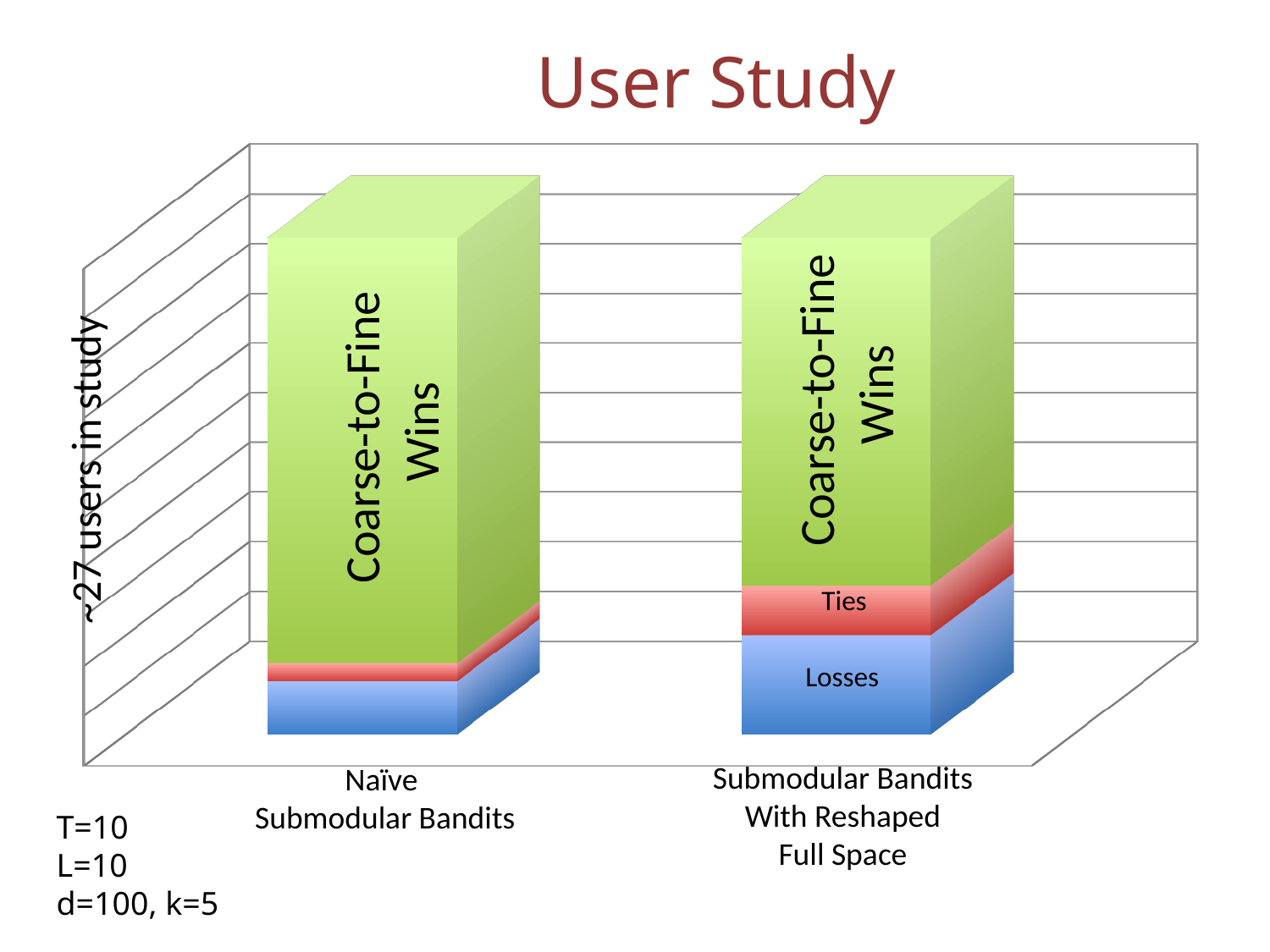
Which segment is the smallest in the Naïve Submodular Bandits bar? Ties What is the title of the chart? User Study Which segment is the smallest in the Submodular Bandits With Reshaped Full Space bar? Ties How many categories (bars) are shown on the x axis? 2 How many stacked segments does each bar contain? 3 Which segment is the largest in the Naïve Submodular Bandits bar? Coarse-to-Fine Wins Which bar has the larger Losses segment, Naïve Submodular Bandits or Submodular Bandits With Reshaped Full Space? Submodular Bandits With Reshaped Full Space What is the label on the vertical axis? ~27 users in study Which bar has the larger Coarse-to-Fine Wins segment, Naïve Submodular Bandits or Submodular Bandits With Reshaped Full Space? Naïve Submodular Bandits What kind of chart is shown on the slide? stacked bar chart Which segment is the largest in the Submodular Bandits With Reshaped Full Space bar? Coarse-to-Fine Wins Which bar has the larger Ties segment, Naïve Submodular Bandits or Submodular Bandits With Reshaped Full Space? Submodular Bandits With Reshaped Full Space